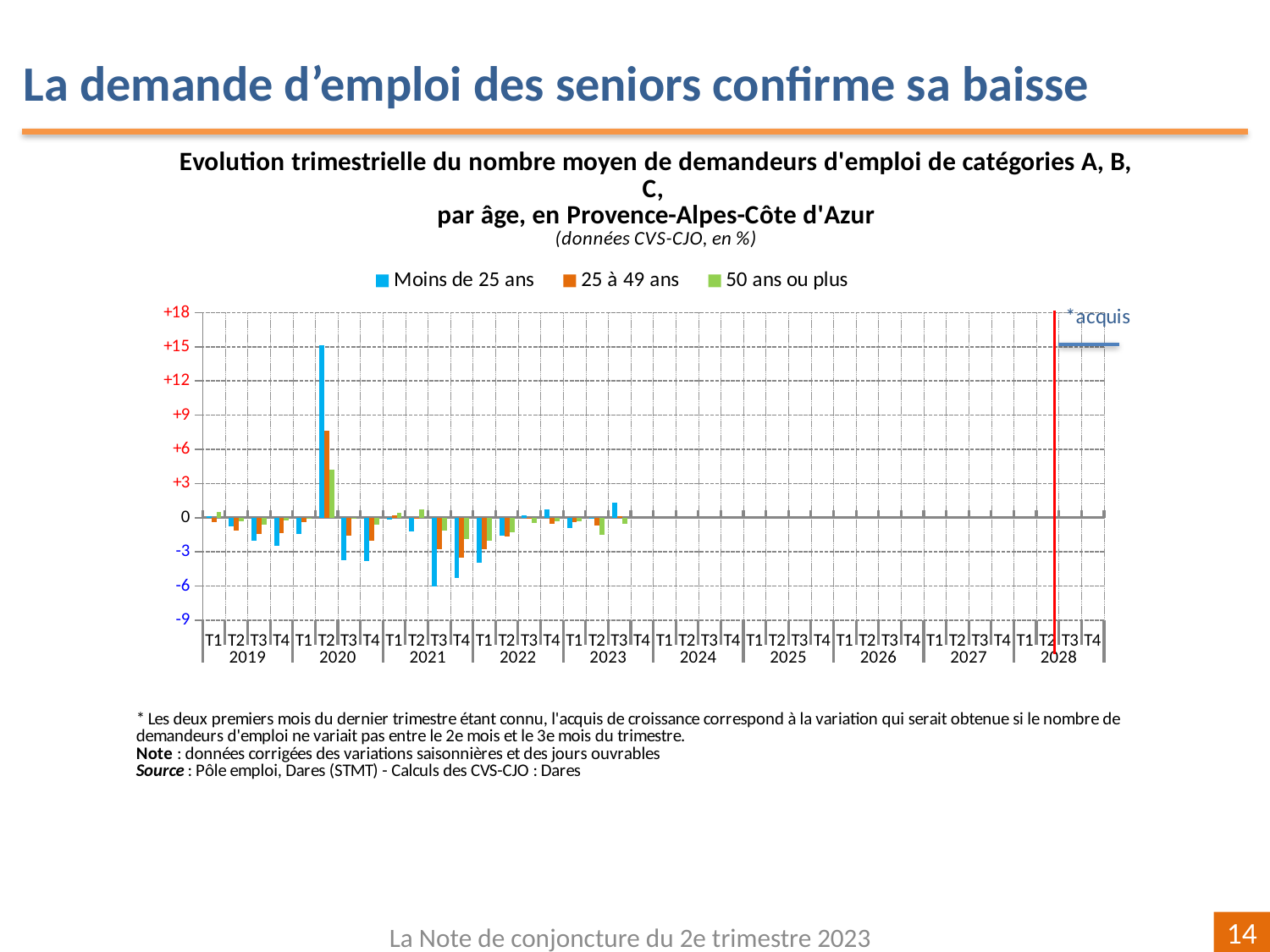
How many series does the legend list? 3 Is the value for Moins de 25 ans in T2 2020 greater or less than +12? greater What are the three series listed in the legend? Moins de 25 ans, 25 à 49 ans, 50 ans ou plus Is the value for 50 ans ou plus in T2 2020 greater or less than +3? greater How many years are labelled along the x axis? 10 What kind of chart is shown on the slide? bar chart Which series and quarter has the highest bar on the chart? Moins de 25 ans, T2 2020 In T2 2020, which series has the larger value: Moins de 25 ans or 25 à 49 ans? Moins de 25 ans What unit is indicated in the chart subtitle in parentheses? données CVS-CJO, en % Which series and quarter has the lowest bar on the chart? Moins de 25 ans, T3 2021 Is the value for Moins de 25 ans in T3 2021 greater or less than -3? less